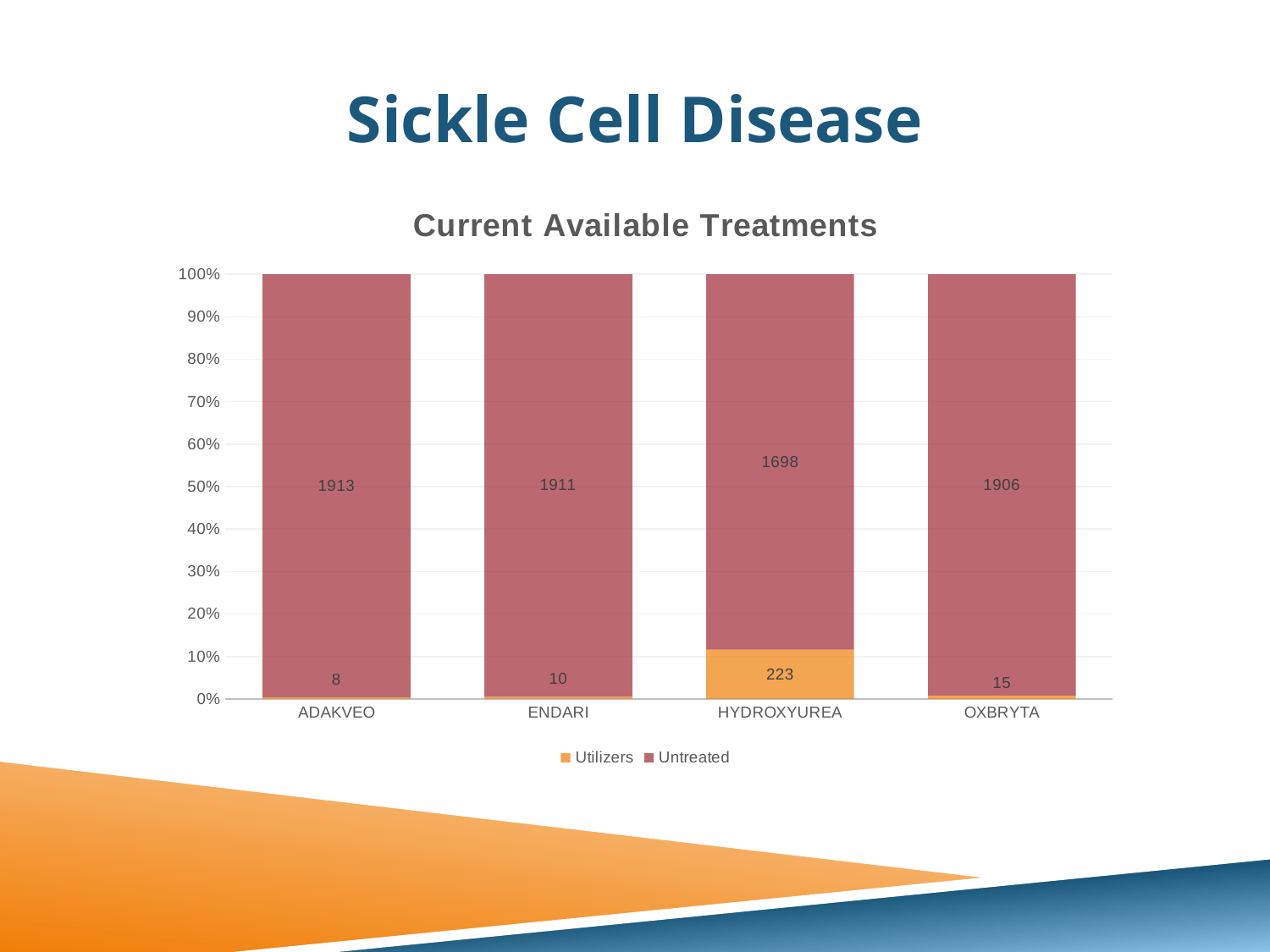
What is the total of Utilizers and Untreated for HYDROXYUREA? 1921 Which is larger, the Untreated value for ENDARI or for OXBRYTA? ENDARI What is the Untreated value for ADAKVEO? 1913 How many treatments are shown on the x axis? 4 Which treatment has the lowest Untreated value? HYDROXYUREA What is the Utilizers value for OXBRYTA? 15 How many series does the legend list? 2 What kind of chart is shown? Stacked bar chart Which treatment has the highest Utilizers value? HYDROXYUREA What is the Utilizers value for HYDROXYUREA? 223 What is the difference between the Utilizers values for HYDROXYUREA and ENDARI? 213 Which treatment has the lowest Utilizers value? ADAKVEO